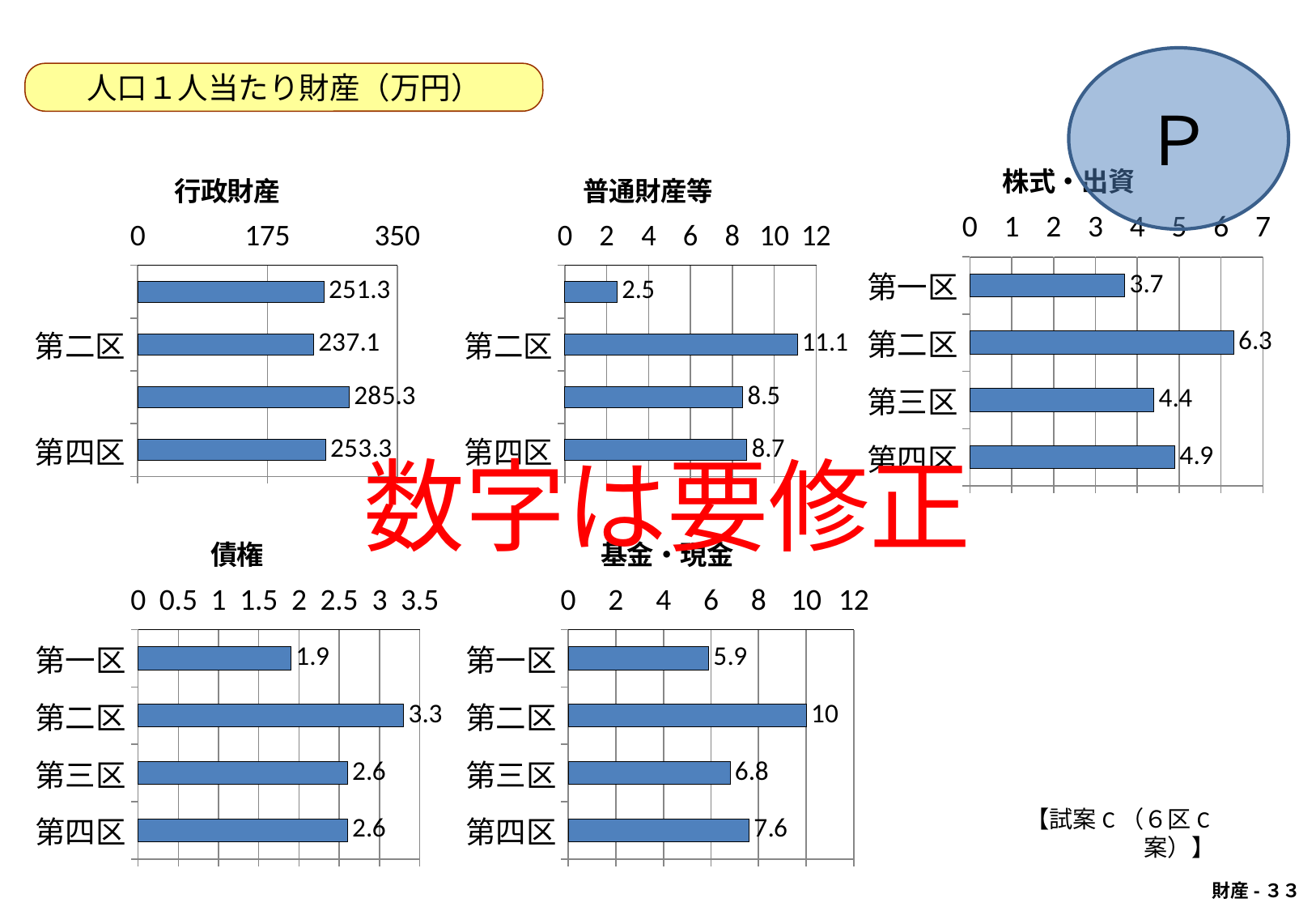
How many bars does the 株式・出資 chart have? 4 In the 基金・現金 chart, is the value for 第一区 greater or less than 6? less In the 行政財産 chart, what is the value for 第四区? 253.3 In the 行政財産 chart, what is the value for 第二区? 237.1 In the 基金・現金 chart, which is larger, 第三区 or 第四区? 第四区 In the 債権 chart, which category has the lowest value? 第一区 In the 株式・出資 chart, what is the difference between 第二区 and 第一区? 2.6 In the 債権 chart, what is the value for 第三区? 2.6 In the 普通財産等 chart, what is the value for 第二区? 11.1 What kind of chart is the 債権 chart? bar chart In the 基金・現金 chart, what is the value for 第二区? 10 In the 株式・出資 chart, which category has the highest value? 第二区